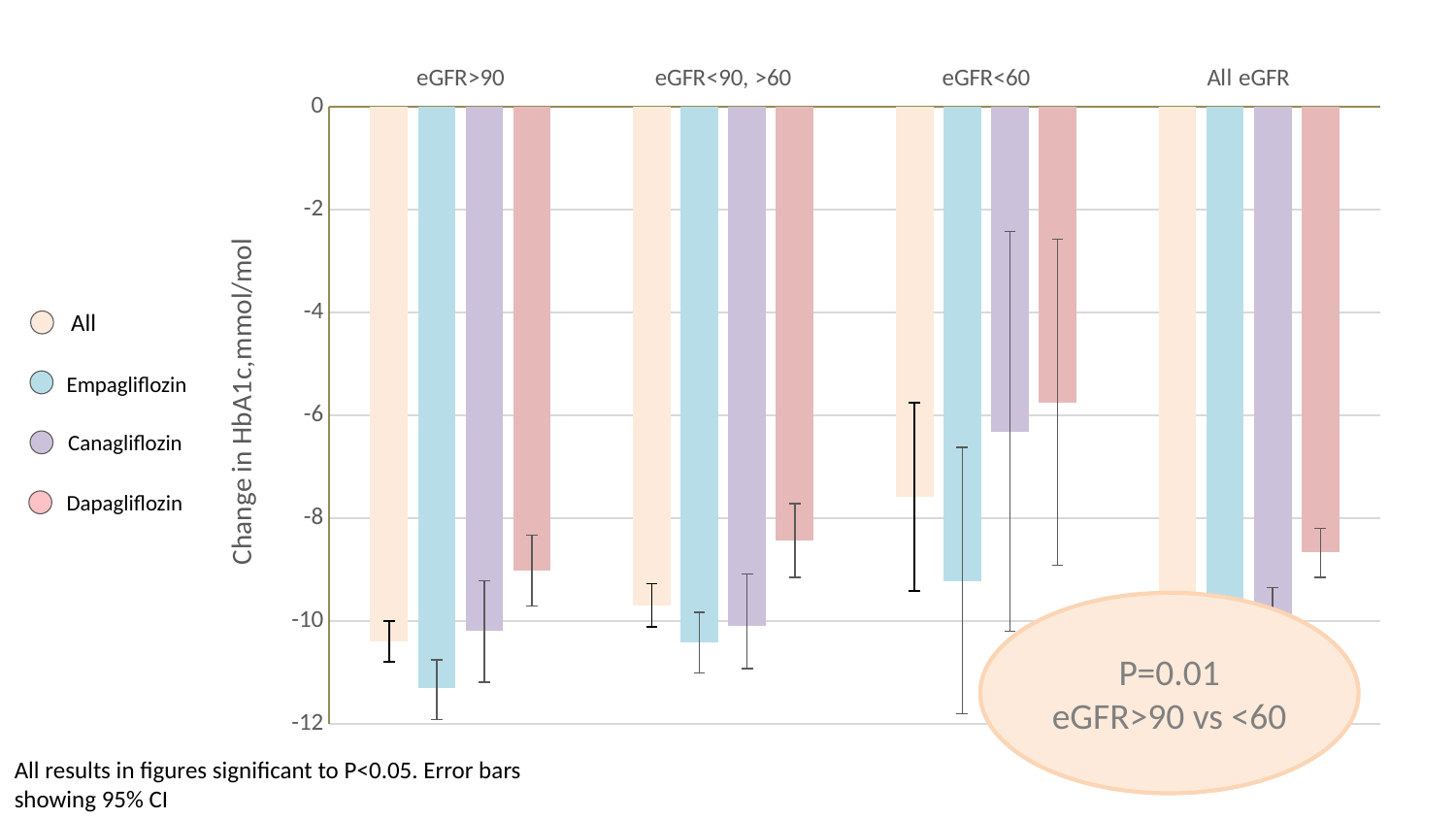
In the eGFR>90 group, which series shows the largest reduction in HbA1c (longest bar)? Empagliflozin Is the value for Empagliflozin in the eGFR<60 group greater or less than -8? less In the eGFR<60 group, which shows a larger reduction in HbA1c, Empagliflozin or Dapagliflozin? Empagliflozin Is the value for Dapagliflozin in the eGFR>90 group greater or less than -10? greater What kind of chart is shown on the slide? bar chart What P value is shown in the annotation comparing eGFR>90 vs <60? P=0.01 What is the label of the y axis? Change in HbA1c, mmol/mol Is the value for All in the eGFR<60 group greater or less than -8? greater In the eGFR<60 group, which series shows the smallest reduction in HbA1c (shortest bar)? Dapagliflozin How many eGFR categories are shown along the x axis? 4 How many series does the legend list? 4